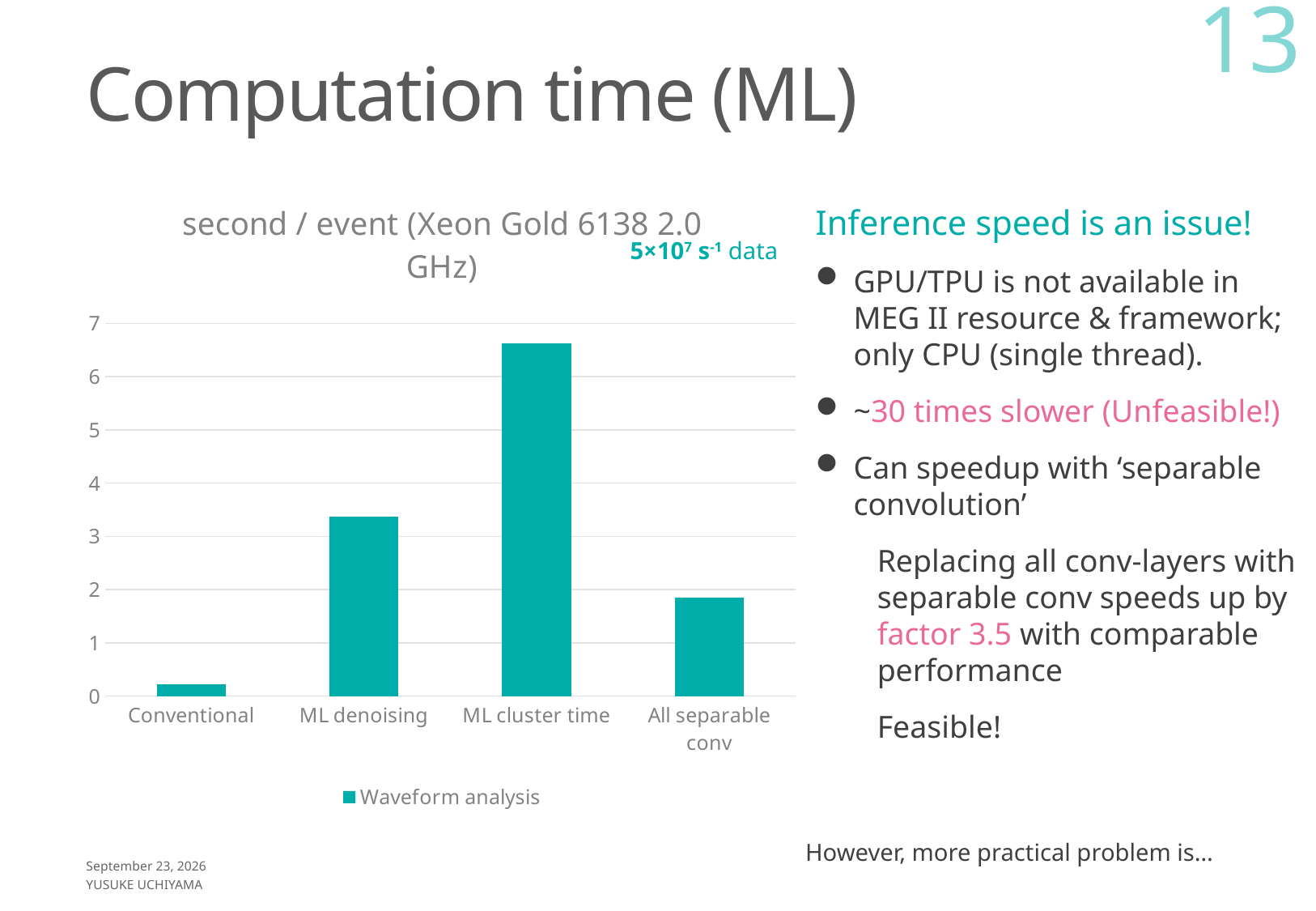
Is the value for All separable conv greater or less than 1? greater Which category has the highest value in the chart? ML cluster time Is the value for ML cluster time greater or less than 6? greater How many series does the chart legend list? 1 Which category has the lowest value in the chart? Conventional Is the value for ML denoising greater or less than 3? greater What type of chart is shown on the slide? bar chart Which is larger, the value for ML denoising or the value for All separable conv? ML denoising What is the name of the series shown in the chart legend? Waveform analysis How many categories are shown on the x axis of the chart? 4 What is the title of the chart? second / event (Xeon Gold 6138 2.0 GHz)